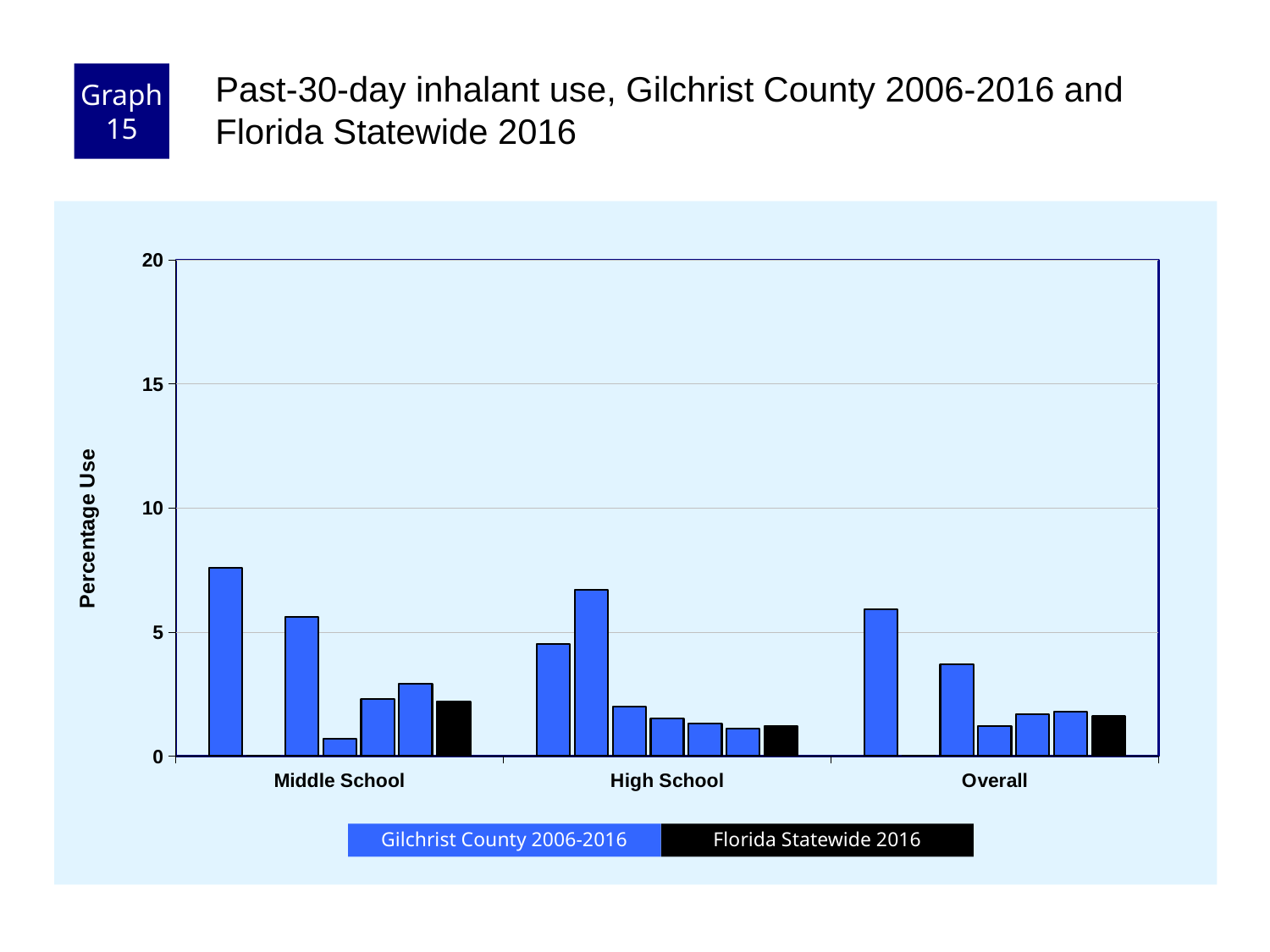
Which category group contains the shortest bar on the chart? Middle School Is the Florida Statewide 2016 value for High School greater or less than 5? less Is the value of the tallest Middle School bar greater or less than 5? greater Which category group contains the tallest bar on the chart? Middle School Is the Florida Statewide 2016 value larger for Middle School or for High School? Middle School How many series does the legend list? 2 Which series is shown in black in the legend? Florida Statewide 2016 How many categories are shown on the x axis? 3 Is the Florida Statewide 2016 value for Middle School greater or less than 5? less What is the label of the y axis? Percentage Use What kind of chart is shown on the slide? bar chart